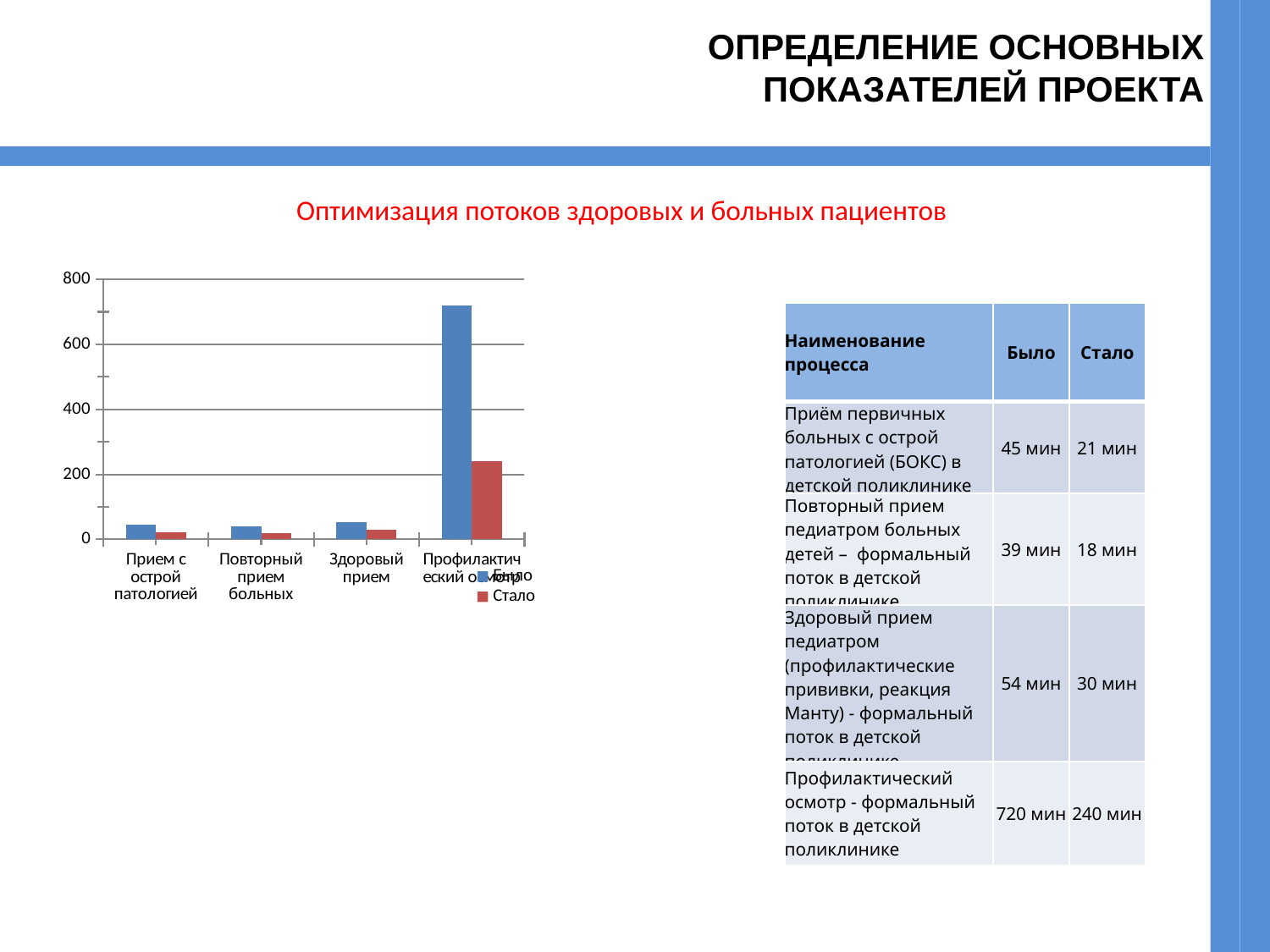
Which category has the highest value for the Было series? Профилактический осмотр How many series does the chart legend list? 2 Is the Стало value for Профилактический осмотр greater or less than 200? greater For Профилактический осмотр, which is larger: the Было value or the Стало value? Было Is the Было value for Прием с острой патологией greater or less than 200? less How many categories are shown on the x axis of the chart? 4 Which series is shown in blue in the chart? Было Which category has the highest value for the Стало series? Профилактический осмотр What kind of chart is shown on the slide? bar chart Is the Было value for Профилактический осмотр greater or less than 600? greater What is the title shown above the chart? Оптимизация потоков здоровых и больных пациентов